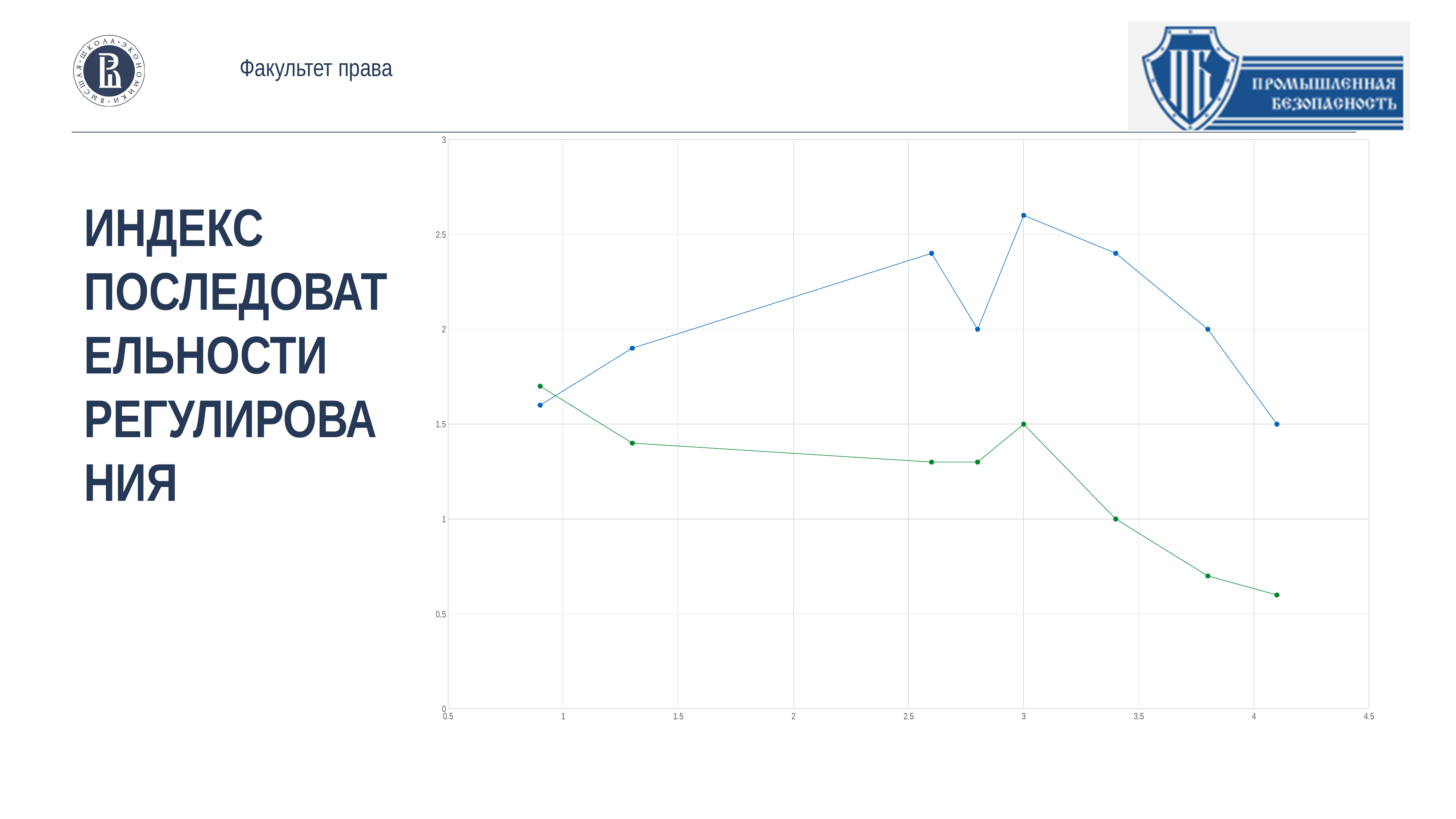
Is the last (rightmost) value of the green series greater or less than 1? less What kind of chart is shown on the slide? line chart What is the maximum value shown on the vertical axis? 3 Which series has the higher value at x = 3, the blue or the green? blue What is the value of the green series at x = 3? 1.5 How many points does the green series have? 8 At which x value does the blue series reach its highest point? 3 Is the first (leftmost) value of the blue series greater or less than 2? less Is the highest value of the blue series greater or less than 2.5? greater How many points does the blue series have? 8 Does the green series generally rise or fall from left to right? fall How many data series are plotted on the chart? 2